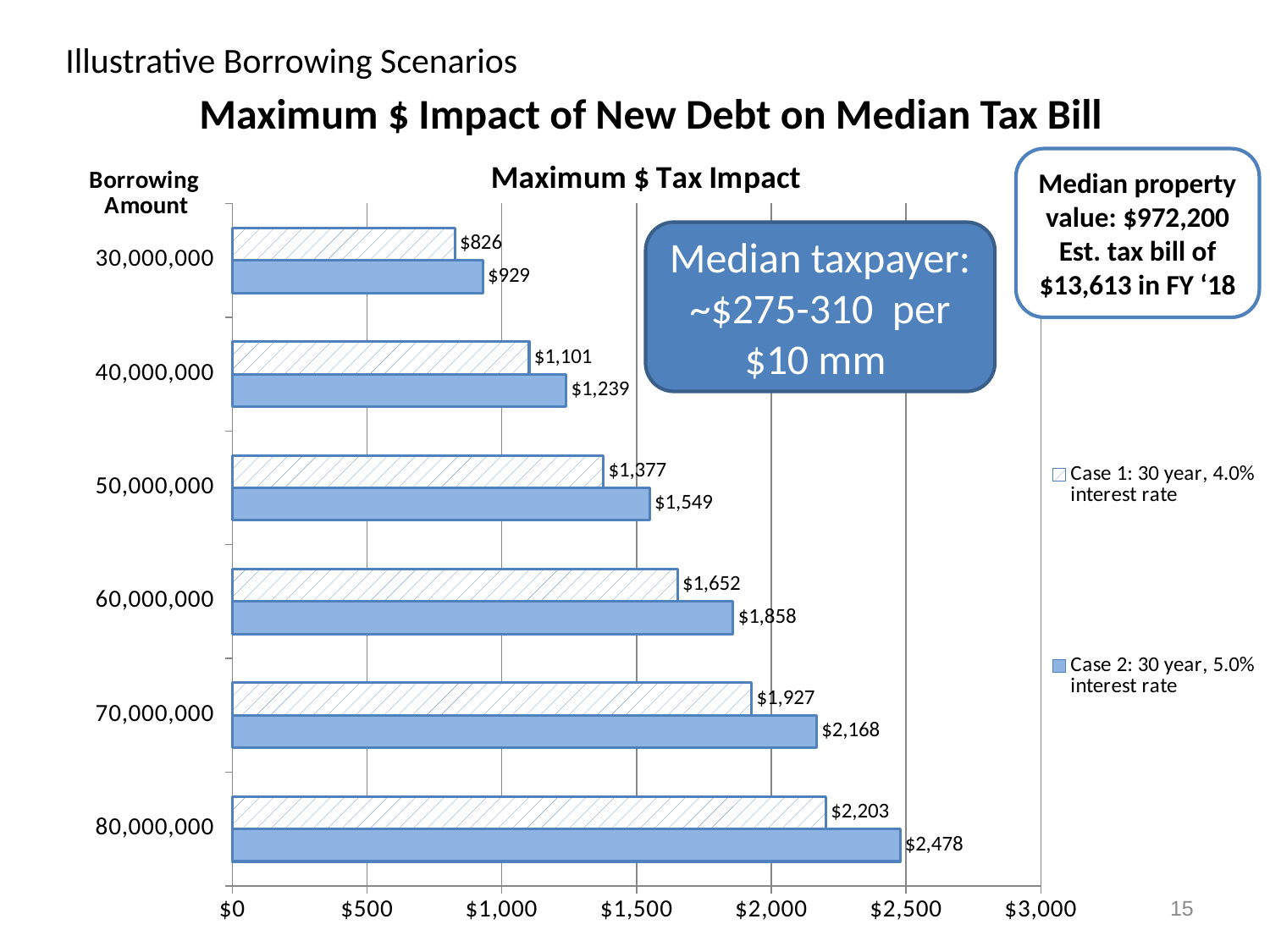
Is the Case 2 value for a borrowing amount of 60,000,000 greater or less than $1,500? greater How many series does the chart legend list? 2 Do the Case 1 values rise or fall as the borrowing amount increases from 30,000,000 to 80,000,000? Rise What is the Case 1 (30 year, 4.0% interest rate) value for a borrowing amount of 70,000,000? $1,927 Which borrowing amount has the highest Case 2 tax impact? 80,000,000 What is the title of the chart? Maximum $ Tax Impact What is the Case 2 (30 year, 5.0% interest rate) value for a borrowing amount of 50,000,000? $1,549 For a borrowing amount of 40,000,000, which is larger: the Case 1 value or the Case 2 value? Case 2 What kind of chart is shown on the slide? Bar chart Which borrowing amount has the lowest Case 1 tax impact? 30,000,000 What is the difference between the Case 2 and Case 1 values for a borrowing amount of 80,000,000? $275 How many borrowing amount categories are shown on the chart? 6